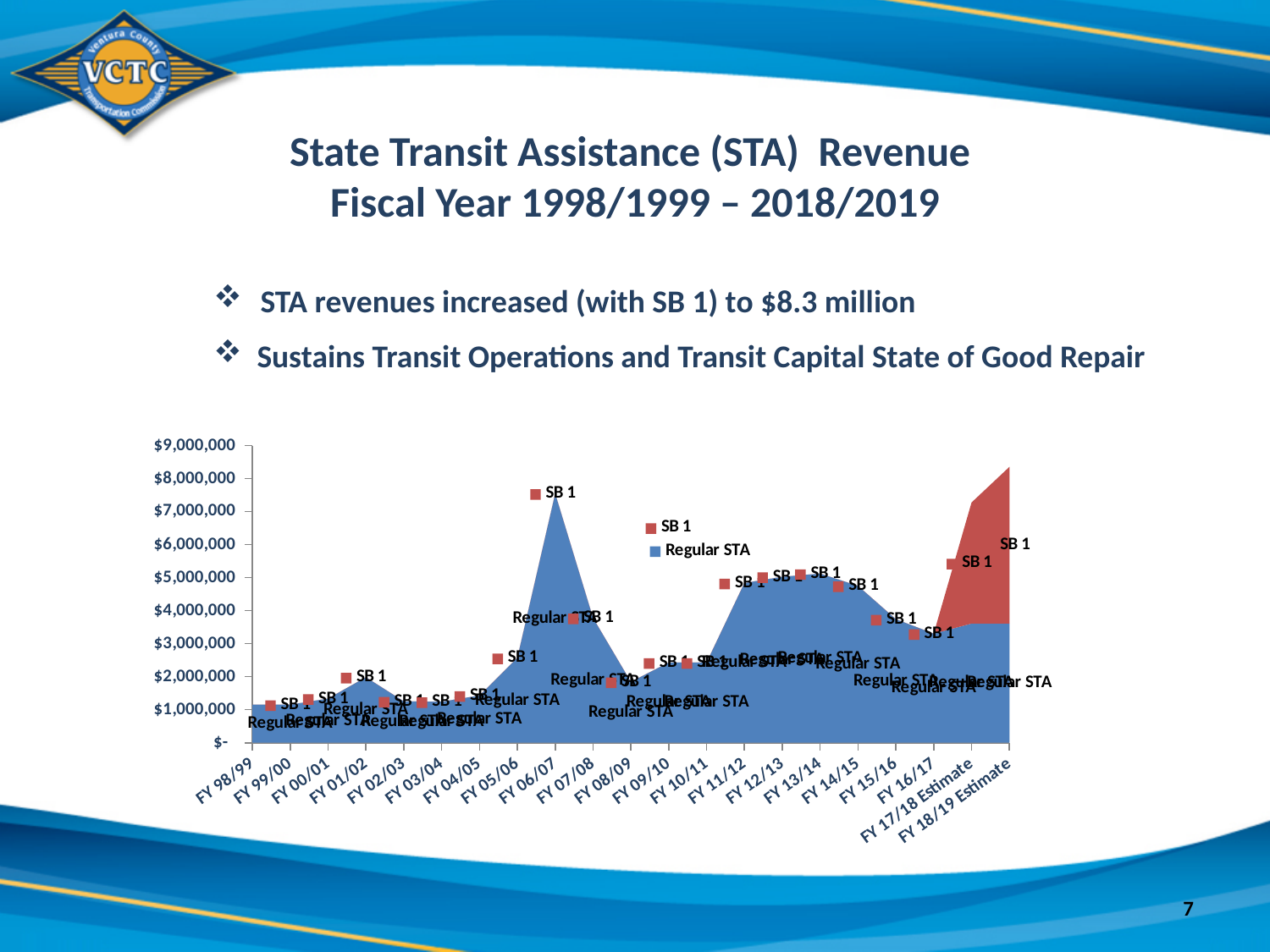
Is the total value for FY 18/19 Estimate greater or less than $8,000,000? greater From FY 13/14 to FY 16/17, does the Regular STA value rise or fall? Fall Which fiscal year has the highest total revenue in the chart? FY 18/19 Estimate How many fiscal years are shown along the x axis of the chart? 21 What kind of chart is shown on the slide? Area chart What are the two series named in the chart's legend? SB 1 and Regular STA Which is larger, the value for FY 06/07 or the value for FY 07/08? FY 06/07 Which is larger, the value for FY 11/12 or the value for FY 08/09? FY 11/12 Is the Regular STA value for FY 06/07 greater or less than $6,000,000? greater Which colour represents the SB 1 series in the chart? Red How many series does the chart's legend list? 2 Is the value for FY 98/99 greater or less than $2,000,000? less